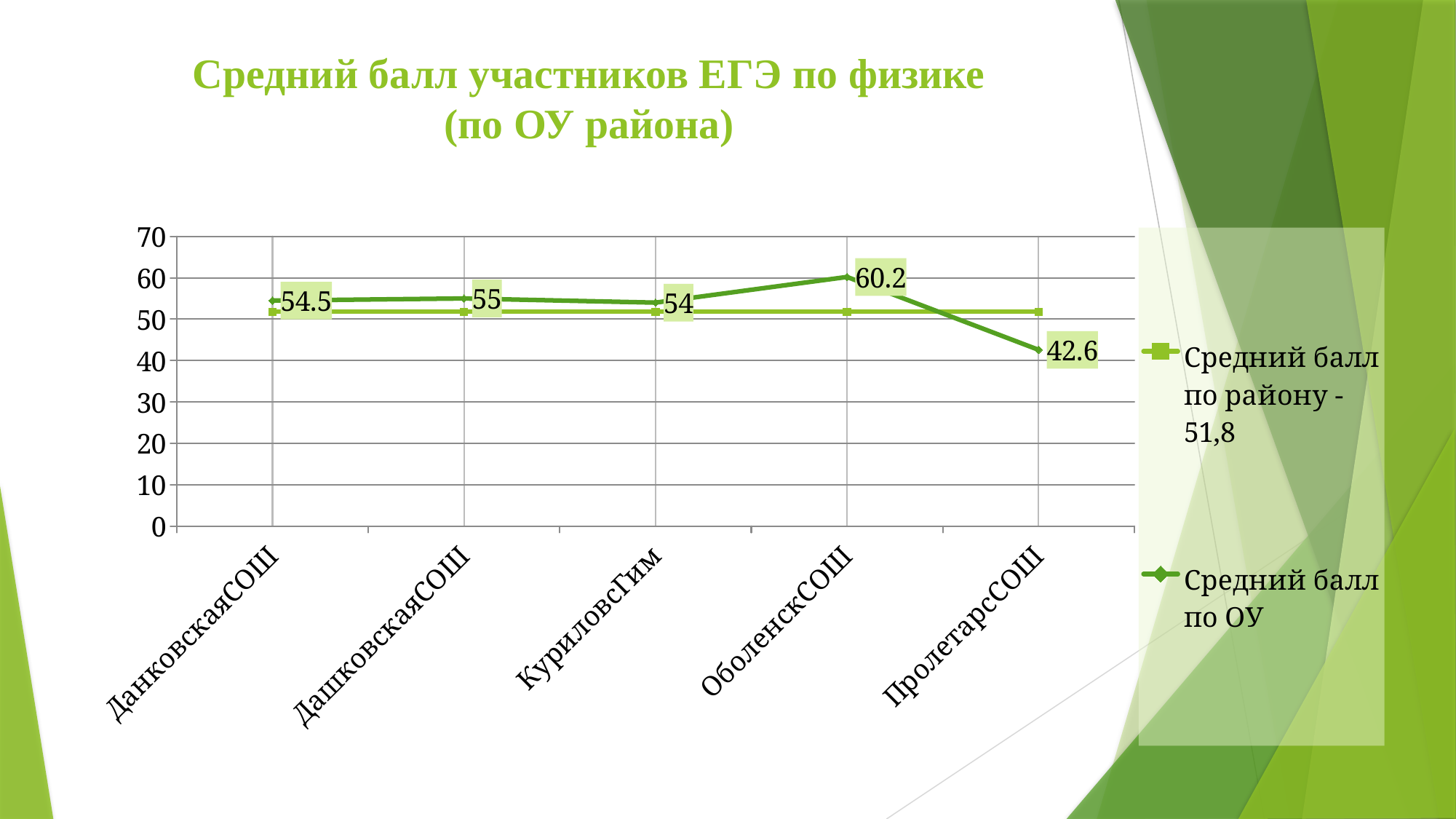
Which has a higher average score, ДашковскаяСОШ or КуриловсГим? ДашковскаяСОШ What is the difference between the average scores of ОболенскСОШ and ПролетарсСОШ? 17.6 What district average value is given in the legend entry 'Средний балл по району'? 51,8 How many series does the legend list? 2 What kind of chart is shown on the slide? line chart Is the average score for ПролетарсСОШ greater or less than 50? less What is the average score (Средний балл по ОУ) for ДанковскаяСОШ? 54.5 What is the average score (Средний балл по ОУ) for ПролетарсСОШ? 42.6 Which school has the highest average score in the Средний балл по ОУ series? ОболенскСОШ Which school has the lowest average score in the Средний балл по ОУ series? ПролетарсСОШ How many schools are shown on the x axis of the chart? 5 What is the average score (Средний балл по ОУ) for ОболенскСОШ? 60.2